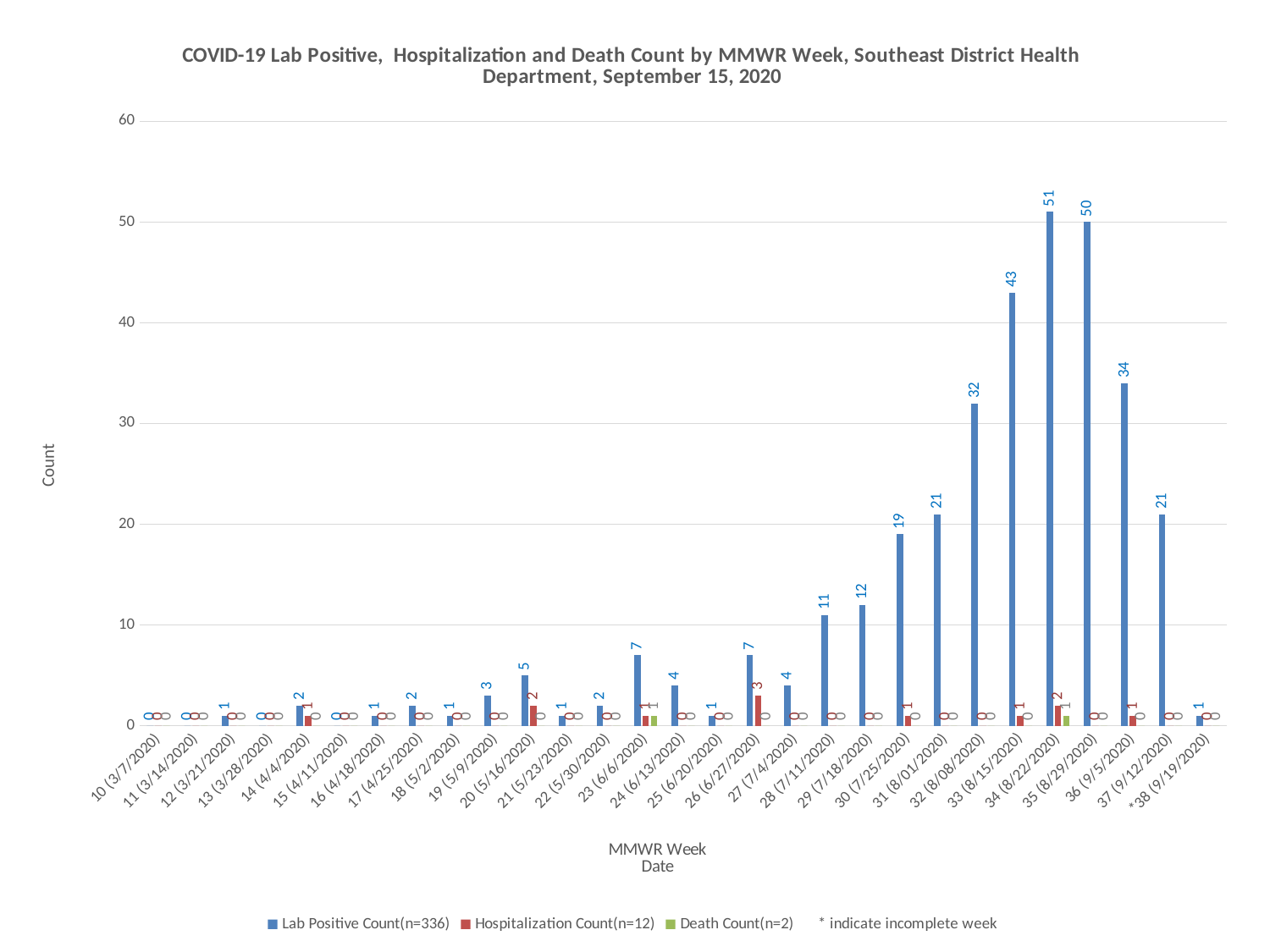
What is the Lab Positive Count for MMWR week 32 (8/08/2020)? 32 What is the Lab Positive Count for MMWR week 34 (8/22/2020)? 51 How many MMWR weeks are shown on the x axis? 29 Which has the larger Lab Positive Count, week 33 (8/15/2020) or week 36 (9/5/2020)? 33 (8/15/2020) What is the difference between the Lab Positive Count for week 33 (8/15/2020) and week 32 (8/08/2020)? 11 What is the Death Count for MMWR week 23 (6/6/2020)? 1 How many series does the legend list? 3 According to the legend note, what does the asterisk (*) indicate? Incomplete week Which MMWR week has the highest Lab Positive Count? 34 (8/22/2020) What is the Hospitalization Count for MMWR week 26 (6/27/2020)? 3 What kind of chart is shown on the slide? Bar chart What is the difference between the Lab Positive Count for week 34 (8/22/2020) and week 35 (8/29/2020)? 1